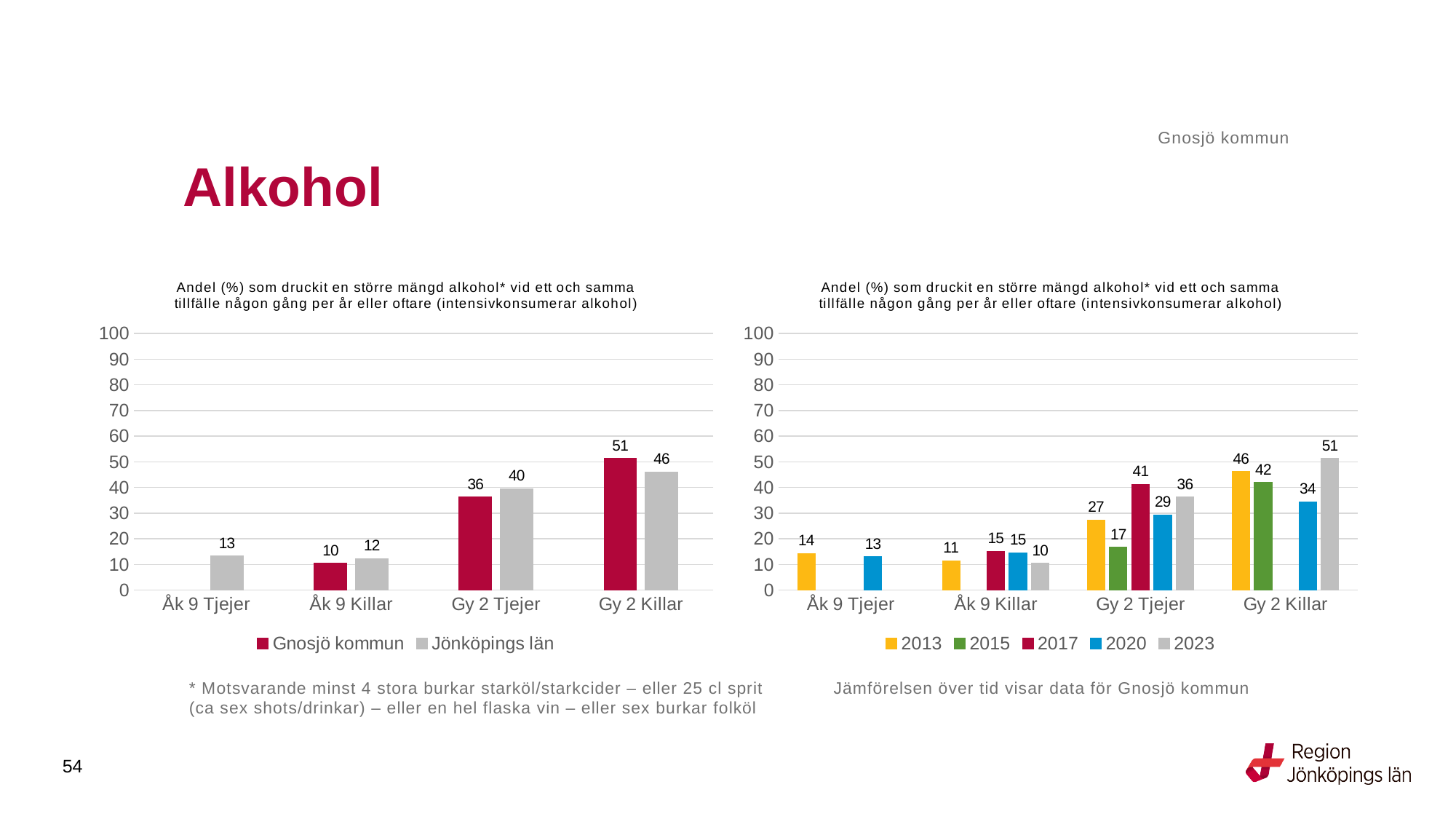
How many series does the legend of the left chart list? 2 In the left chart, which is larger for Åk 9 Killar: Gnosjö kommun or Jönköpings län? Jönköpings län In the right chart, what is the value for 2023 for Gy 2 Killar? 51 In the left chart, which category has the highest value for Jönköpings län? Gy 2 Killar In the right chart, what is the difference between 2023 and 2020 for Gy 2 Killar? 17 In the left chart, what is the value for Gnosjö kommun for Gy 2 Killar? 51 In the right chart, which year has the lowest value for Gy 2 Tjejer? 2015 In the left chart, what is the difference between Gnosjö kommun and Jönköpings län for Gy 2 Killar? 5 How many series does the legend of the right chart list? 5 In the right chart, what is the value for 2017 for Gy 2 Tjejer? 41 In the left chart, what is the value for Jönköpings län for Gy 2 Tjejer? 40 What kind of chart is the right chart? Bar chart